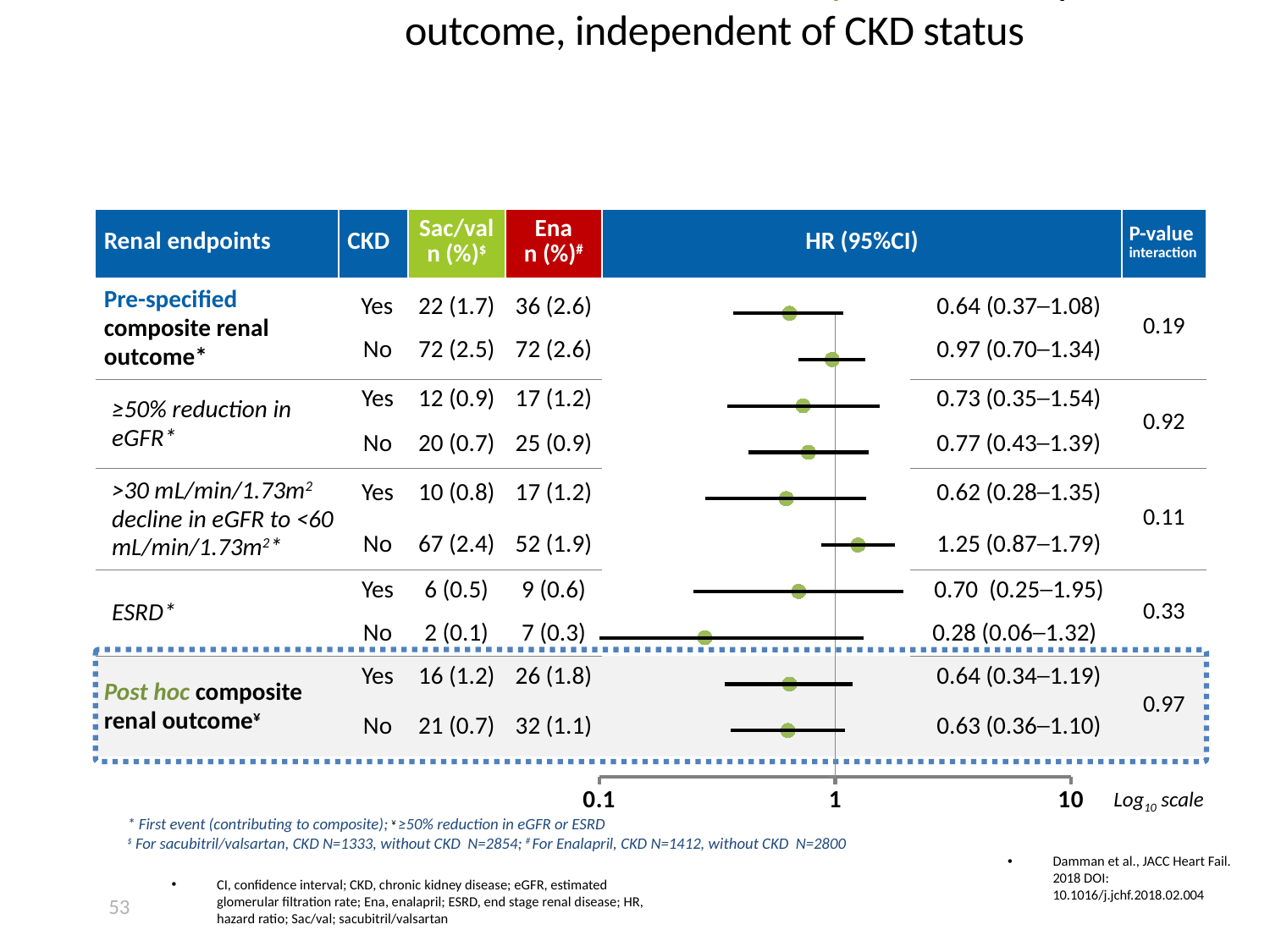
What is the HR (95%CI) for the pre-specified composite renal outcome in patients with CKD (Yes)? 0.64 (0.37–1.08) How many hazard ratio point estimates are plotted in the forest plot? 10 What is the P-value for interaction for the post hoc composite renal outcome? 0.97 What scale is used on the x axis of the forest plot? Log10 scale Is the hazard ratio point estimate for the >30 mL/min/1.73m² decline in eGFR endpoint in patients without CKD greater or less than 1? greater For the ESRD endpoint, is the hazard ratio larger for patients with CKD (Yes) or without CKD (No)? Yes (0.70 vs 0.28) What is the HR (95%CI) for the >30 mL/min/1.73m² decline in eGFR to <60 mL/min/1.73m² endpoint in patients without CKD (No)? 1.25 (0.87–1.79) What is the P-value for interaction for the ESRD endpoint? 0.33 What is the difference between the hazard ratio point estimates for the pre-specified composite renal outcome in patients without CKD and with CKD? 0.33 What is the Sac/val n (%) for ESRD in patients with CKD (Yes)? 6 (0.5) Which row in the forest plot has the lowest hazard ratio point estimate? ESRD, CKD No (0.28) Which row in the forest plot has the highest hazard ratio point estimate? >30 mL/min/1.73m² decline in eGFR to <60 mL/min/1.73m², CKD No (1.25)